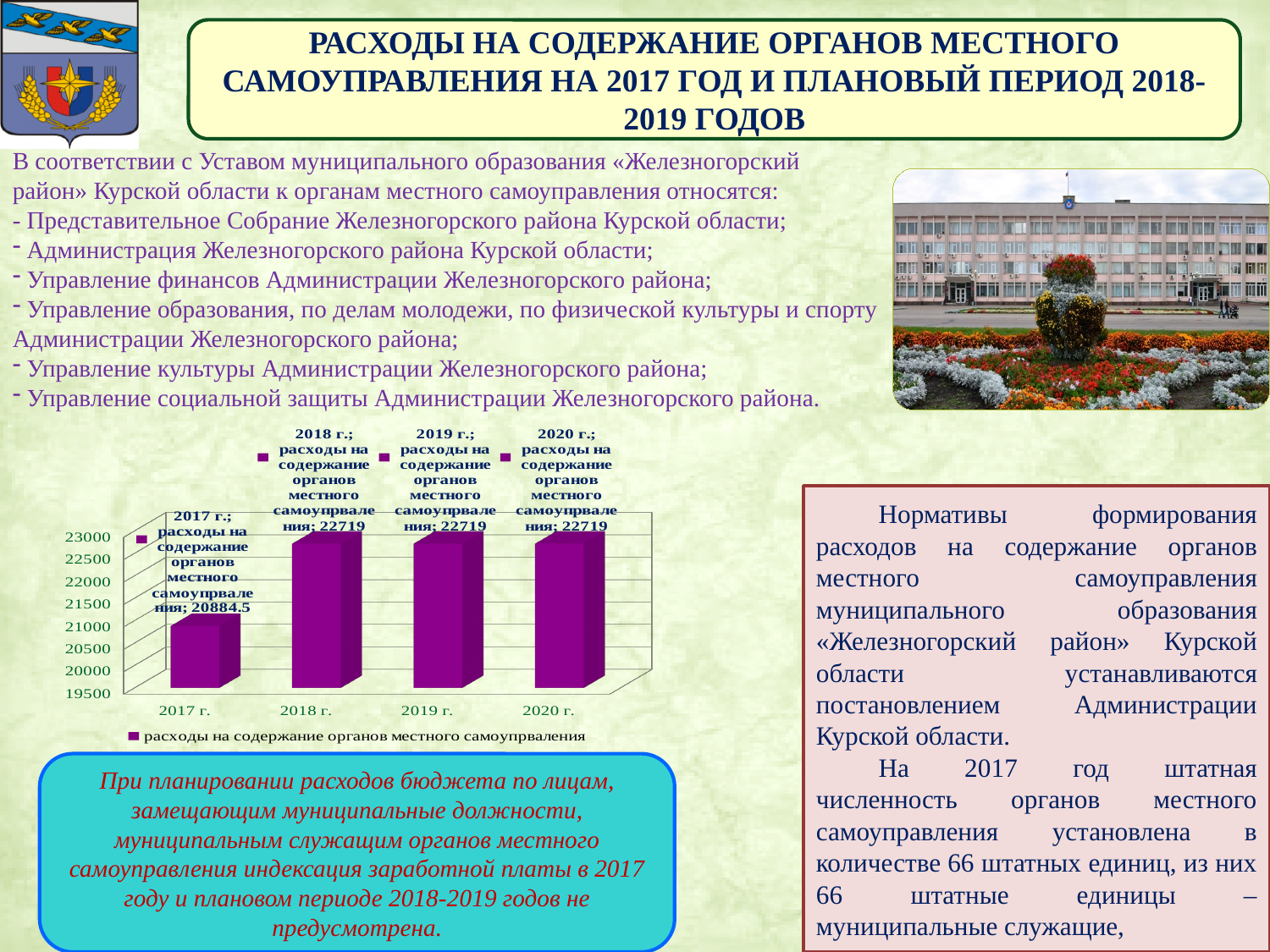
Is the value for 2017 г. greater or less than 21000? less What is the value for 2020 г. in the chart? 22719 What is the value for 2018 г. in the chart? 22719 What type of chart is shown on the slide? bar chart What is the difference between the values for 2018 г. and 2017 г.? 1834.5 What is the value for 2017 г. in the chart? 20884.5 What is the name of the series shown in the chart legend? расходы на содержание органов местного самоупрваления Which year has the lowest value in the chart? 2017 г. How many years (categories) are shown on the x axis of the chart? 4 How many series does the chart legend list? 1 Is the value for 2019 г. greater or less than 22500? greater Which is larger, the value for 2017 г. or the value for 2019 г.? 2019 г.